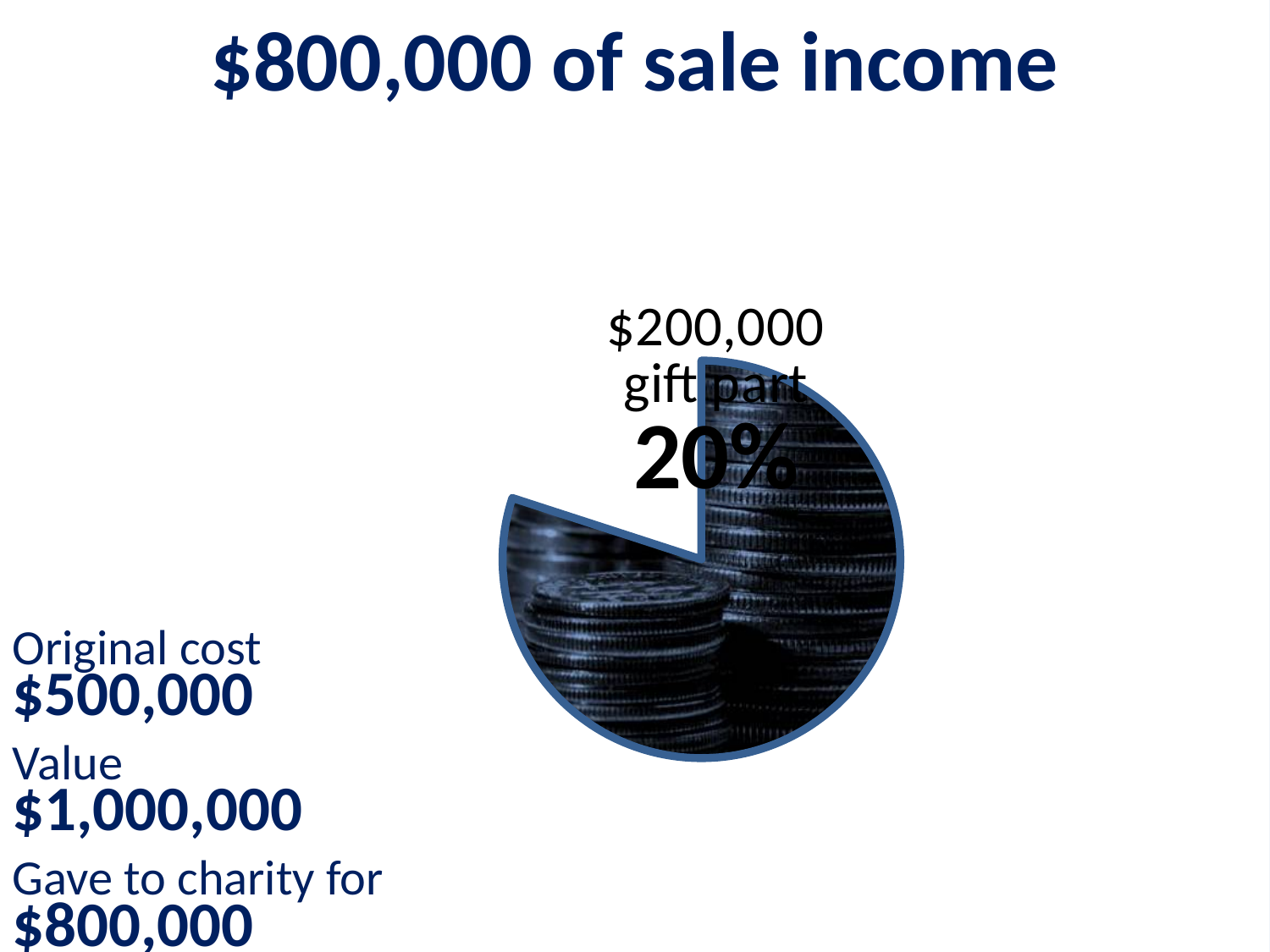
What label is given to the cut-out slice of the pie chart? $200,000 gift part What is the title of the slide containing the pie chart? $800,000 of sale income What share of the pie does the gift part represent? 20% What kind of chart is shown on the slide? pie chart What percentage is printed on the pie chart? 20% What dollar value is labelled for the gift part on the pie chart? $200,000